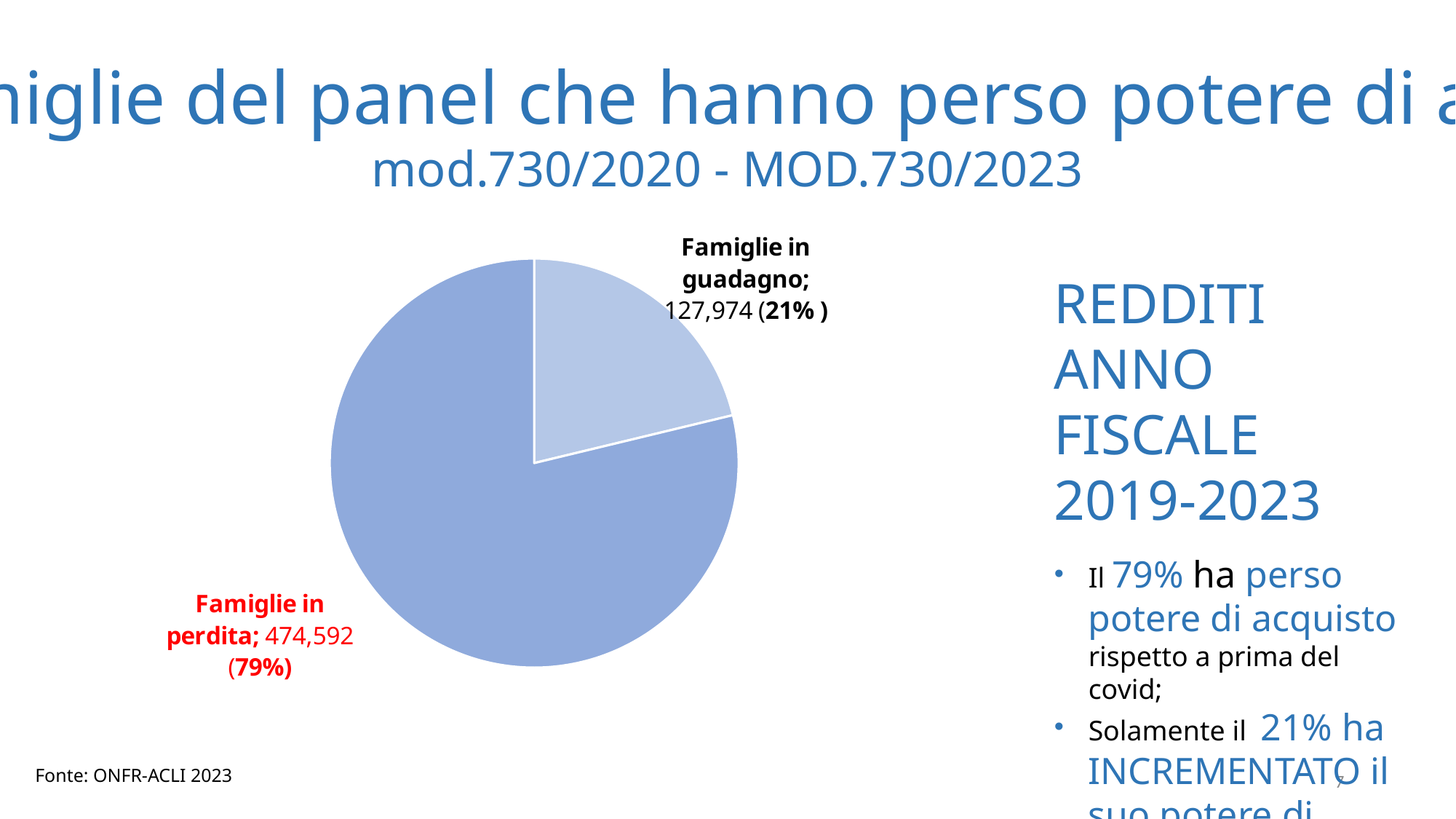
What share of the pie does "Famiglie in guadagno" represent? 21% What is the difference between the values for "Famiglie in perdita" and "Famiglie in guadagno"? 346,618 Which slice of the pie chart is the smallest? Famiglie in guadagno What is the total of the two values shown in the pie chart? 602,566 What share of the pie does "Famiglie in perdita" represent? 79% Which is larger: "Famiglie in guadagno" or "Famiglie in perdita"? Famiglie in perdita What kind of chart is shown on the slide? Pie chart What is the value for "Famiglie in guadagno" in the pie chart? 127,974 What is the value for "Famiglie in perdita" in the pie chart? 474,592 Which slice of the pie chart is the largest? Famiglie in perdita What source is cited below the pie chart? Fonte: ONFR-ACLI 2023 How many slices does the pie chart have? 2